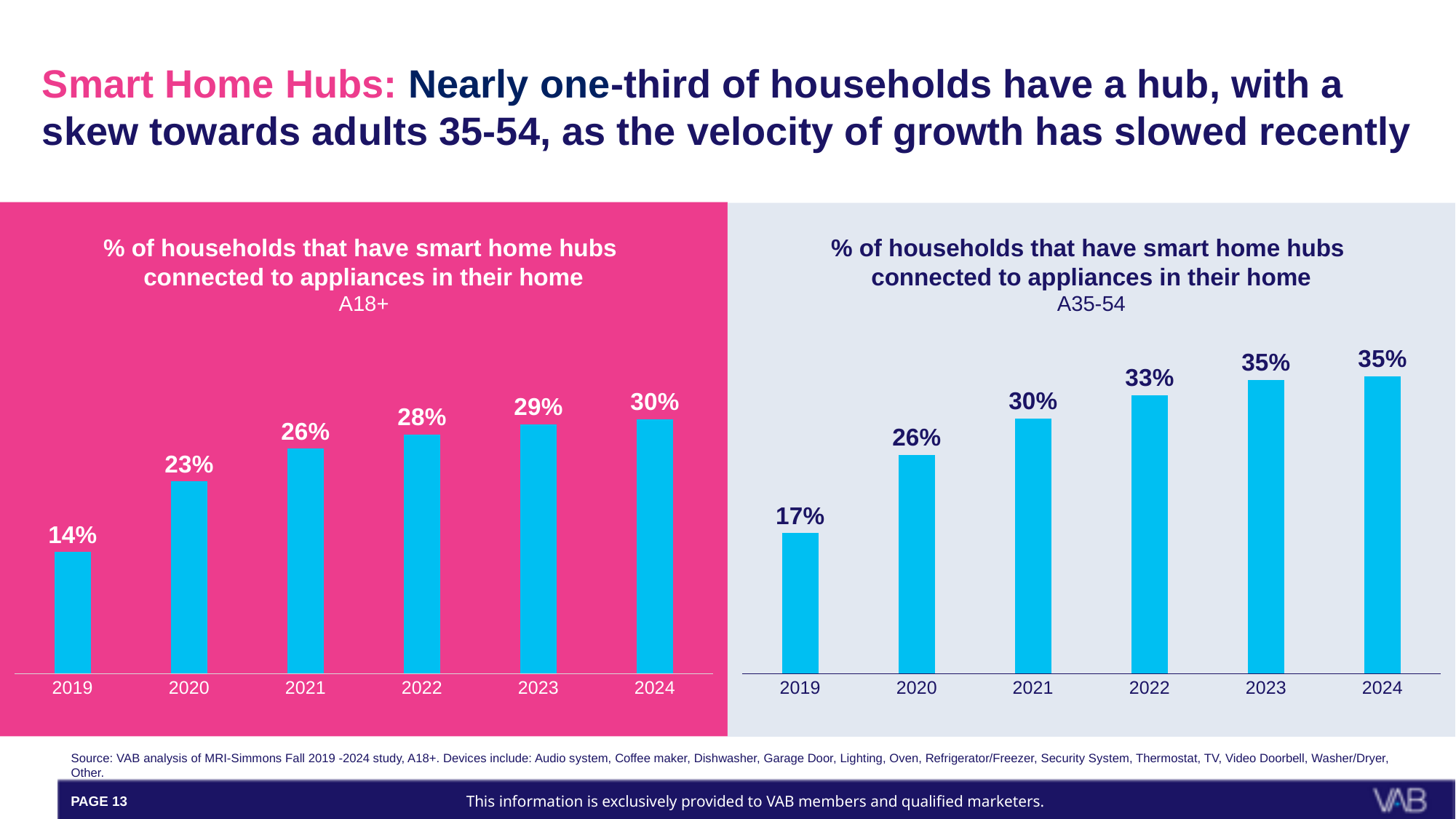
In the A18+ chart on the left, do the values rise or fall from 2019 to 2024? Rise In the A35-54 chart on the right, what is the value for 2022? 33% In the A35-54 chart on the right, what is the difference between the 2021 value and the 2020 value? 4% What kind of chart is the A35-54 chart on the right? Bar chart In the A18+ chart on the left, what is the value for 2019? 14% How many years are shown on the x axis of the A18+ chart on the left? 6 In the A18+ chart on the left, what is the difference between the 2024 value and the 2019 value? 16% What audience is the chart on the right about, as shown under its title? A35-54 Which is larger: the 2022 value in the A18+ chart on the left or the 2022 value in the A35-54 chart on the right? A35-54 chart (33%) In the A35-54 chart on the right, what is the value for 2023? 35% In the A18+ chart on the left, which year has the highest value? 2024 In the A35-54 chart on the right, which year has the lowest value? 2019